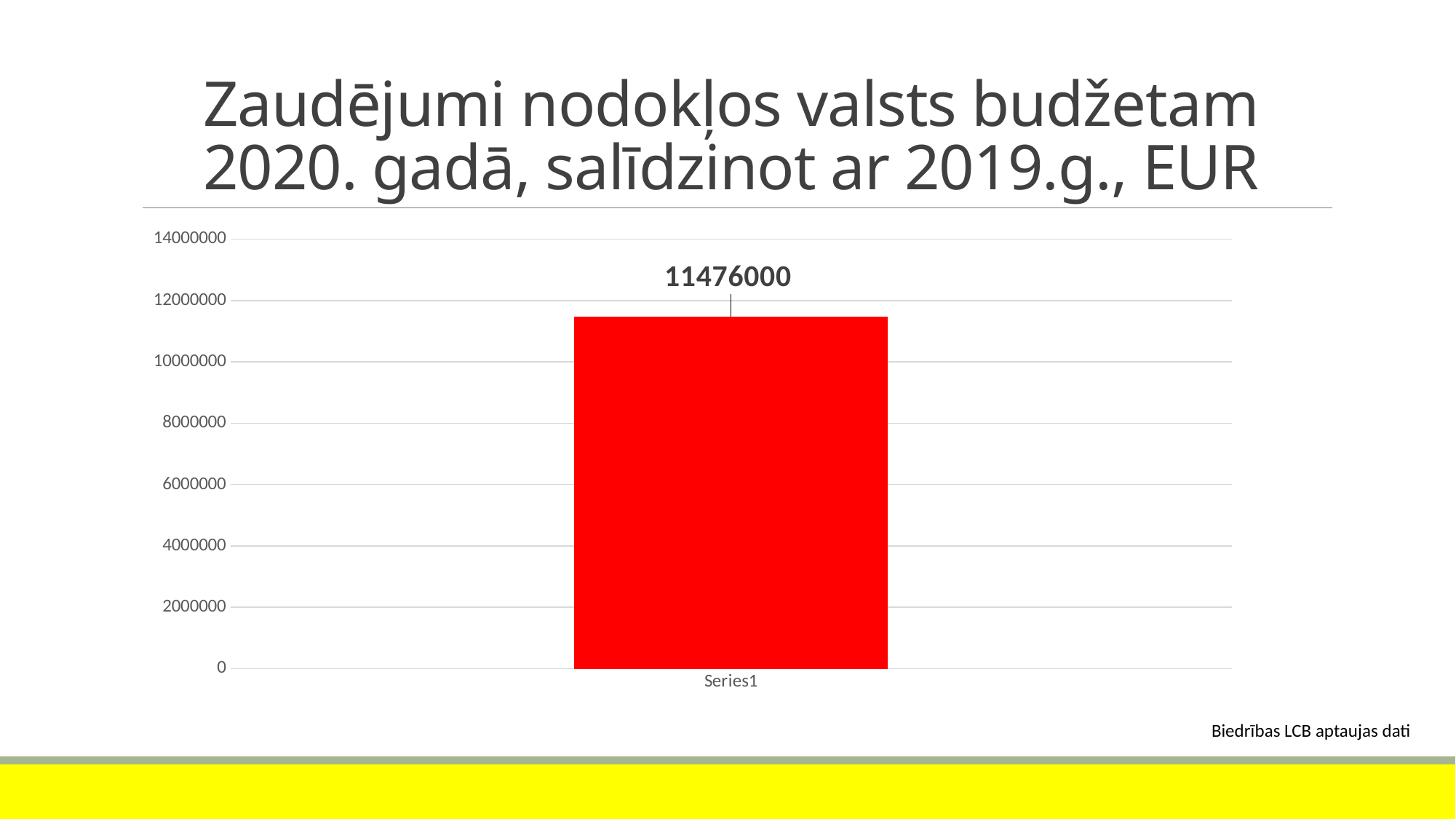
What colour is the bar in the chart? red What kind of chart is shown on the slide? bar chart What is the category label shown under the bar? Series1 What is the highest value shown on the vertical axis? 14000000 What is the value shown for Series1? 11476000 Is the value for Series1 greater or less than 10000000? greater Is the value for Series1 greater or less than 12000000? less How many bars are plotted in the chart? 1